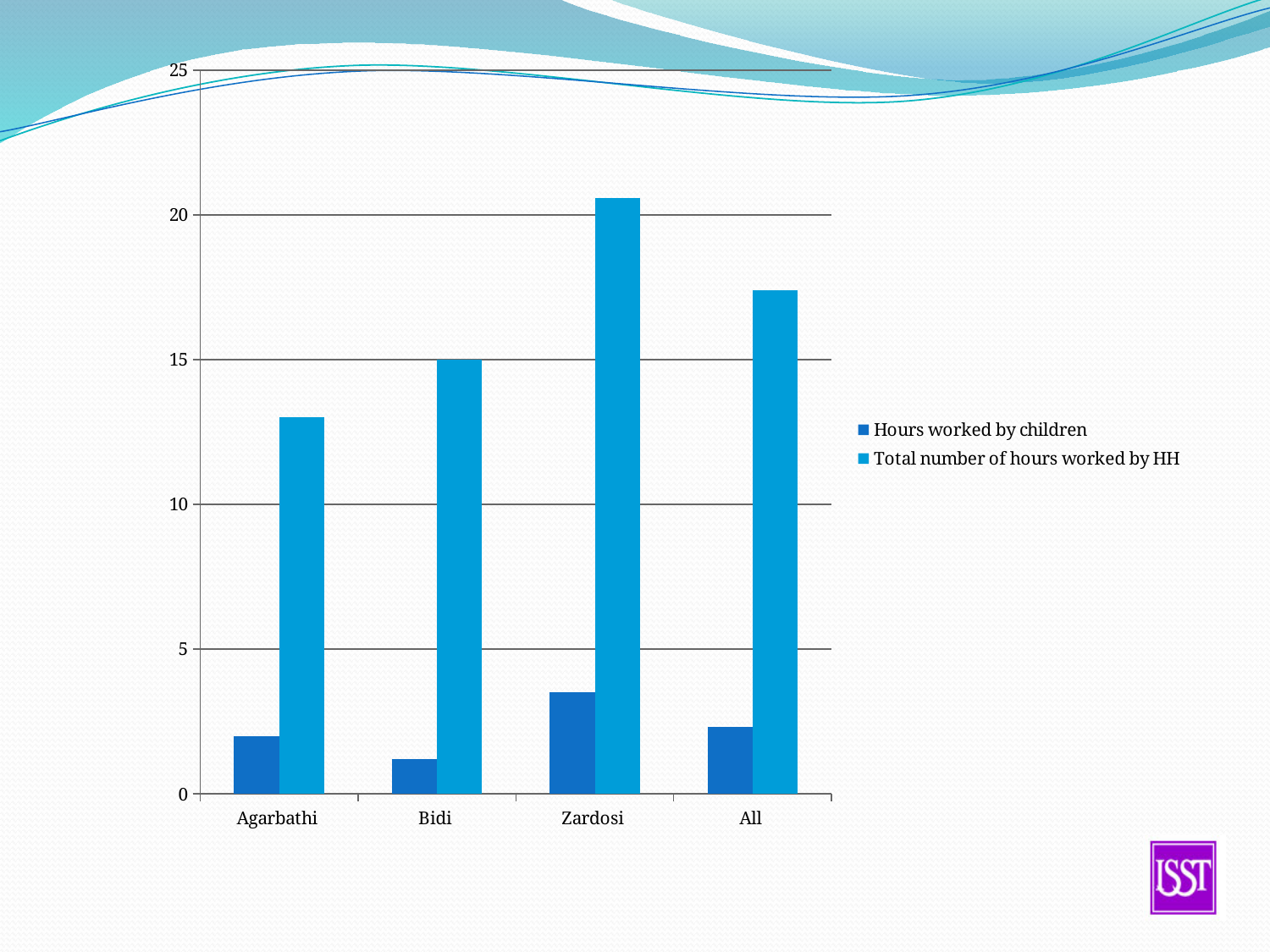
What kind of chart is shown on the slide? bar chart How many series does the legend list? 2 Which category has the lowest value for Total number of hours worked by HH? Agarbathi Is the value for Hours worked by children for Zardosi greater or less than 5? less Which category has the highest value for Total number of hours worked by HH? Zardosi Is the value for Total number of hours worked by HH for Zardosi greater or less than 20? greater Which is larger: Total number of hours worked by HH for All or for Bidi? All What is the second entry listed in the legend? Total number of hours worked by HH Which category has the lowest value for Hours worked by children? Bidi Which category has the highest value for Hours worked by children? Zardosi Is the value for Total number of hours worked by HH for Agarbathi greater or less than 15? less How many categories are shown on the x axis? 4